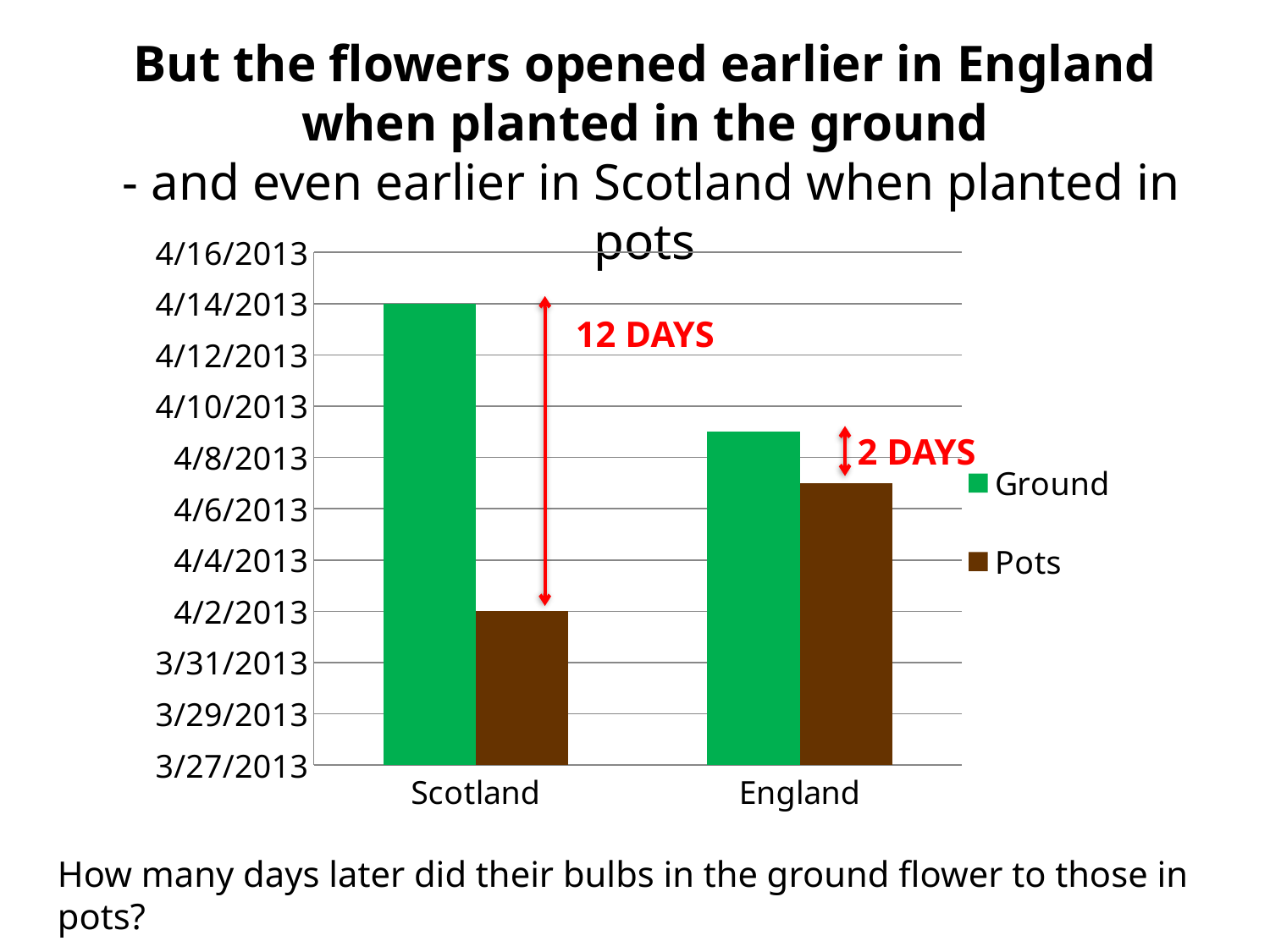
According to the annotation, how many days apart are the Ground and Pots flowering dates for England? 2 DAYS Which bar shows the earliest flowering date on the chart? Scotland Pots What date does the Ground bar for Scotland reach? 4/14/2013 Which has the later Ground flowering date, Scotland or England? Scotland Which bar shows the latest flowering date on the chart? Scotland Ground Is the Pots bar for England above or below the 4/8/2013 gridline? below What kind of chart is shown on the slide? bar chart Is the Ground bar for England above or below the 4/8/2013 gridline? above What date does the Pots bar for Scotland reach? 4/2/2013 According to the annotation, how many days apart are the Ground and Pots flowering dates for Scotland? 12 DAYS How many countries are shown on the x axis? 2 How many series does the legend list? 2